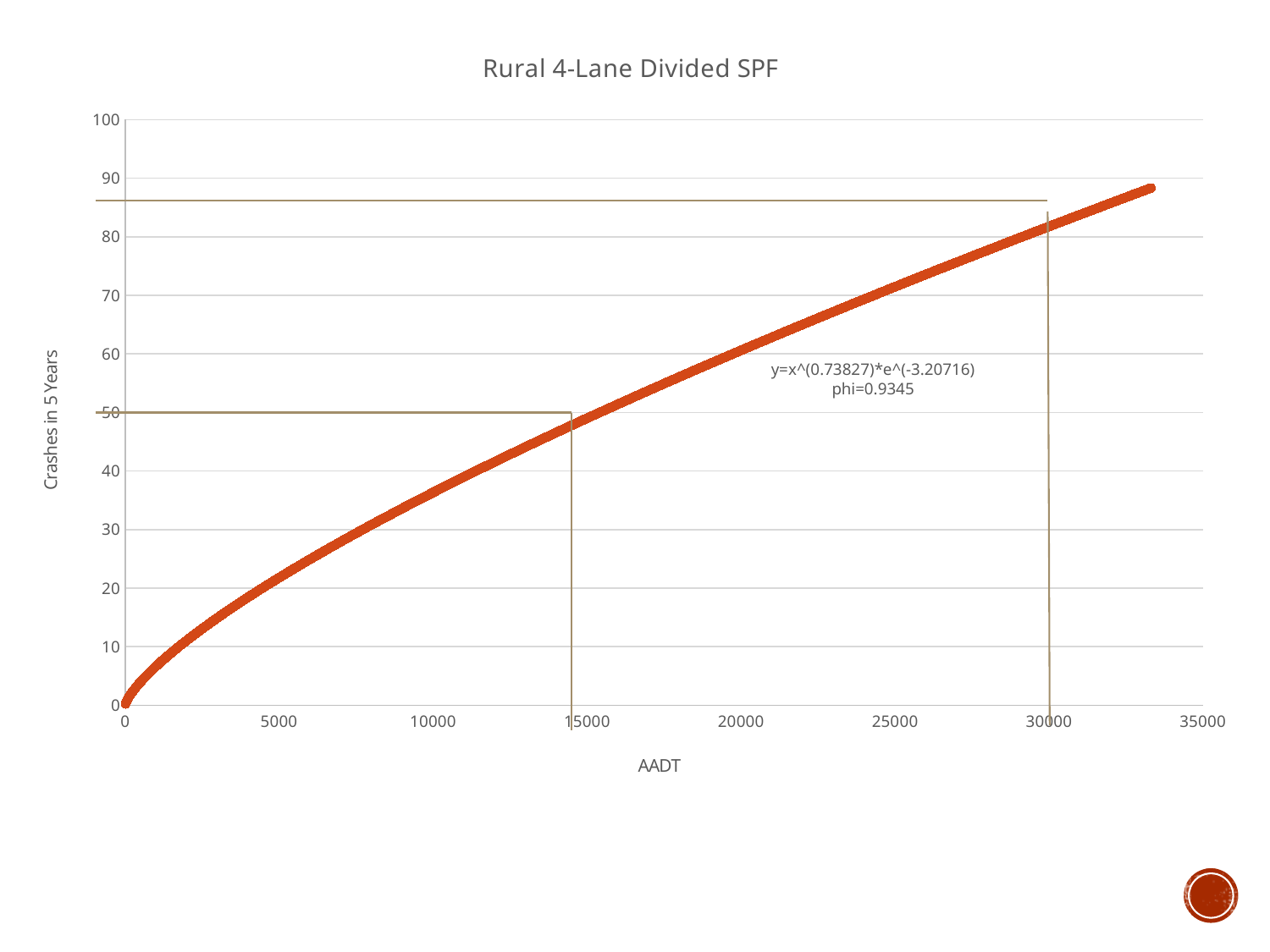
What is the label of the x axis? AADT Is the value for Crashes in 5 Years at an AADT of 5000 greater or less than 30? less Is the value for Crashes in 5 Years at an AADT of 25000 greater or less than 60? greater Is the value for Crashes in 5 Years at an AADT of 15000 greater or less than 40? greater What kind of chart is shown on the slide? line chart What equation is printed on the chart for the curve? y=x^(0.73827)*e^(-3.20716) Do the plotted values rise or fall as AADT increases? rise What value of phi is printed on the chart? 0.9345 What is the highest tick value shown on the y axis? 100 What is the title of the chart? Rural 4-Lane Divided SPF